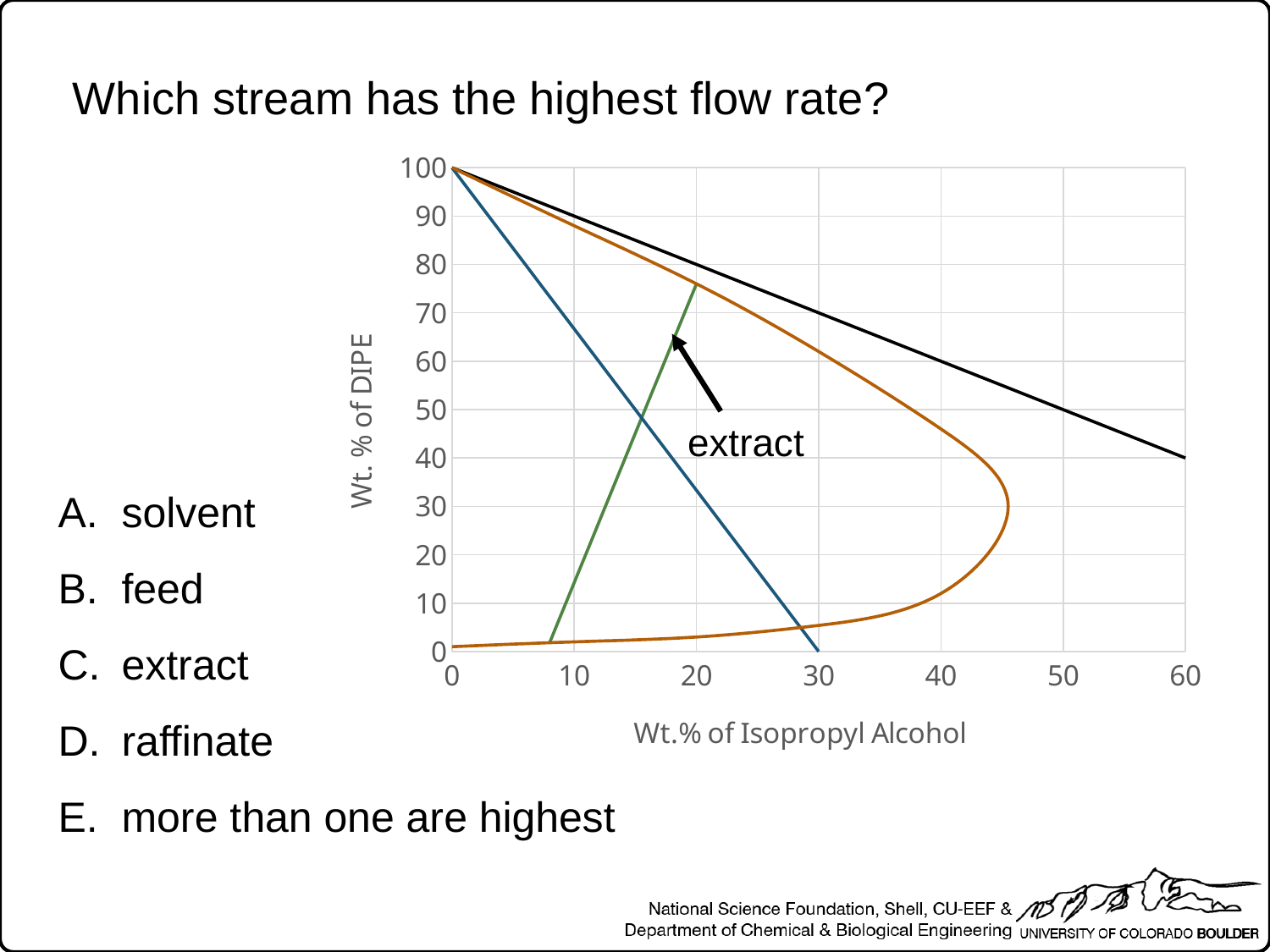
Is the Wt. % of DIPE at the lower end of the green line greater or less than 10? less Is the maximum Wt.% of Isopropyl Alcohol reached by the orange curve greater or less than 40? greater Does the blue line rise or fall as Wt.% of Isopropyl Alcohol increases? falls How many lines are plotted on the chart? 4 Which line on the chart is labeled "extract"? the green line At what Wt. % of DIPE does the black line end at 60 Wt.% of Isopropyl Alcohol? 40 What is the title of the x axis of the chart? Wt.% of Isopropyl Alcohol Does the black line rise or fall as Wt.% of Isopropyl Alcohol increases? falls At what Wt. % of DIPE do the black and blue lines start at 0 Wt.% of Isopropyl Alcohol? 100 At what Wt.% of Isopropyl Alcohol does the blue line reach 0 Wt. % of DIPE? 30 What kind of chart is shown on the slide? line chart Is the Wt. % of DIPE at the upper end of the green line greater or less than 70? greater